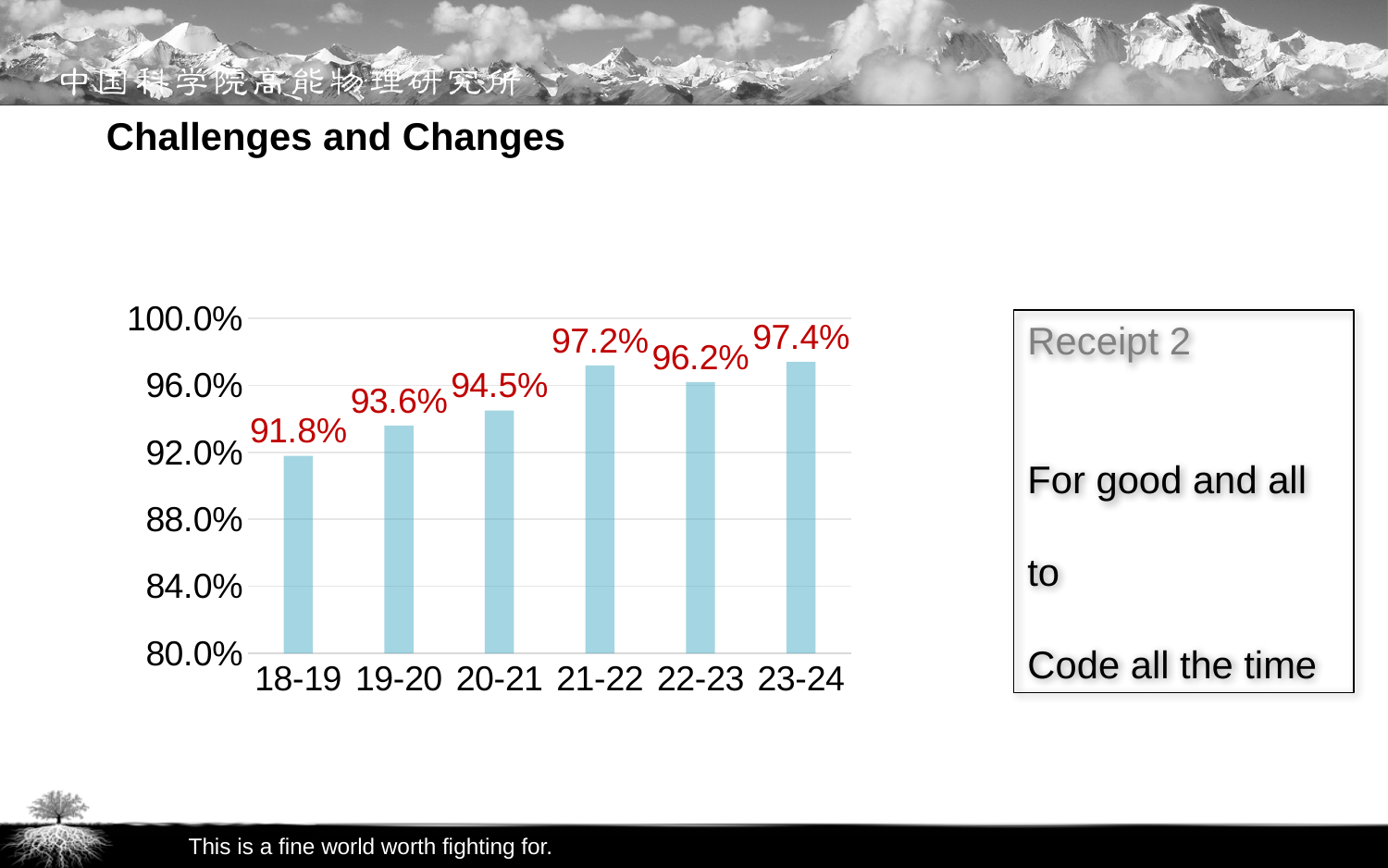
How many categories are shown on the x axis? 6 What is the value for 21-22? 97.2% What is the value for 18-19? 91.8% Which is larger, the value for 21-22 or the value for 22-23? 21-22 Do the values generally rise or fall from 18-19 to 23-24? rise Which category has the lowest value? 18-19 What is the difference between the values for 19-20 and 20-21? 0.9% Which category has the highest value? 23-24 What is the value for 22-23? 96.2% What kind of chart is this? bar chart Is the value for 20-21 greater or less than 96.0%? less What is the difference between the values for 23-24 and 18-19? 5.6%